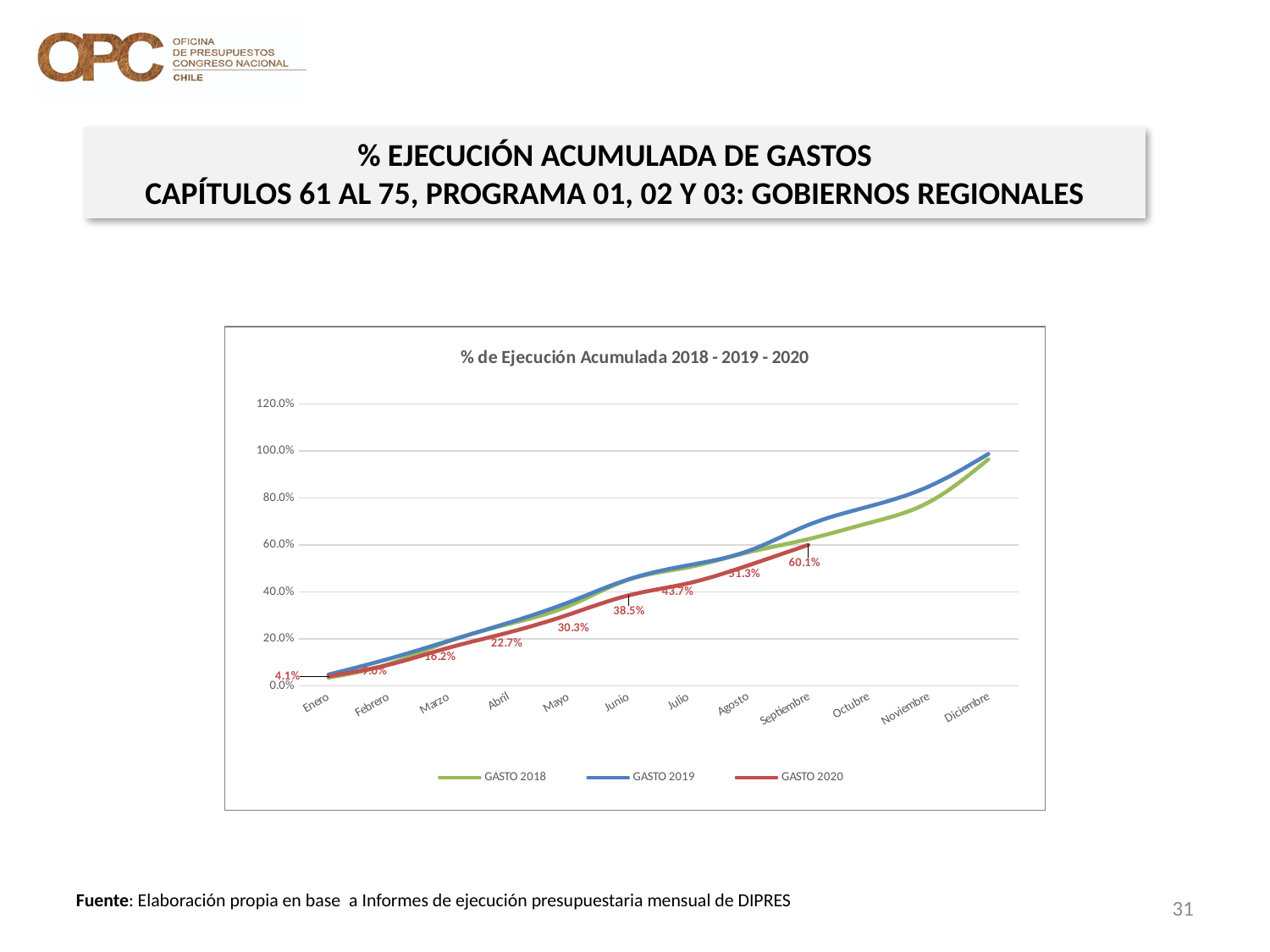
What is the difference between the GASTO 2020 values for Septiembre and Agosto? 8.8 percentage points Do the values for GASTO 2020 rise or fall from Enero to Septiembre? Rise What is the value for GASTO 2020 in Agosto? 51.3% What is the value for GASTO 2020 in Septiembre? 60.1% What is the value for GASTO 2020 in Marzo? 16.2% Which of the two is larger: GASTO 2020 in Mayo or GASTO 2020 in Julio? Julio What is the value for GASTO 2020 in Junio? 38.5% What kind of chart is shown? Line chart How many months are shown on the x axis? 12 What is the value for GASTO 2020 in Abril? 22.7% Is the value for GASTO 2019 in Diciembre greater or less than 80.0%? greater How many series does the legend list? 3